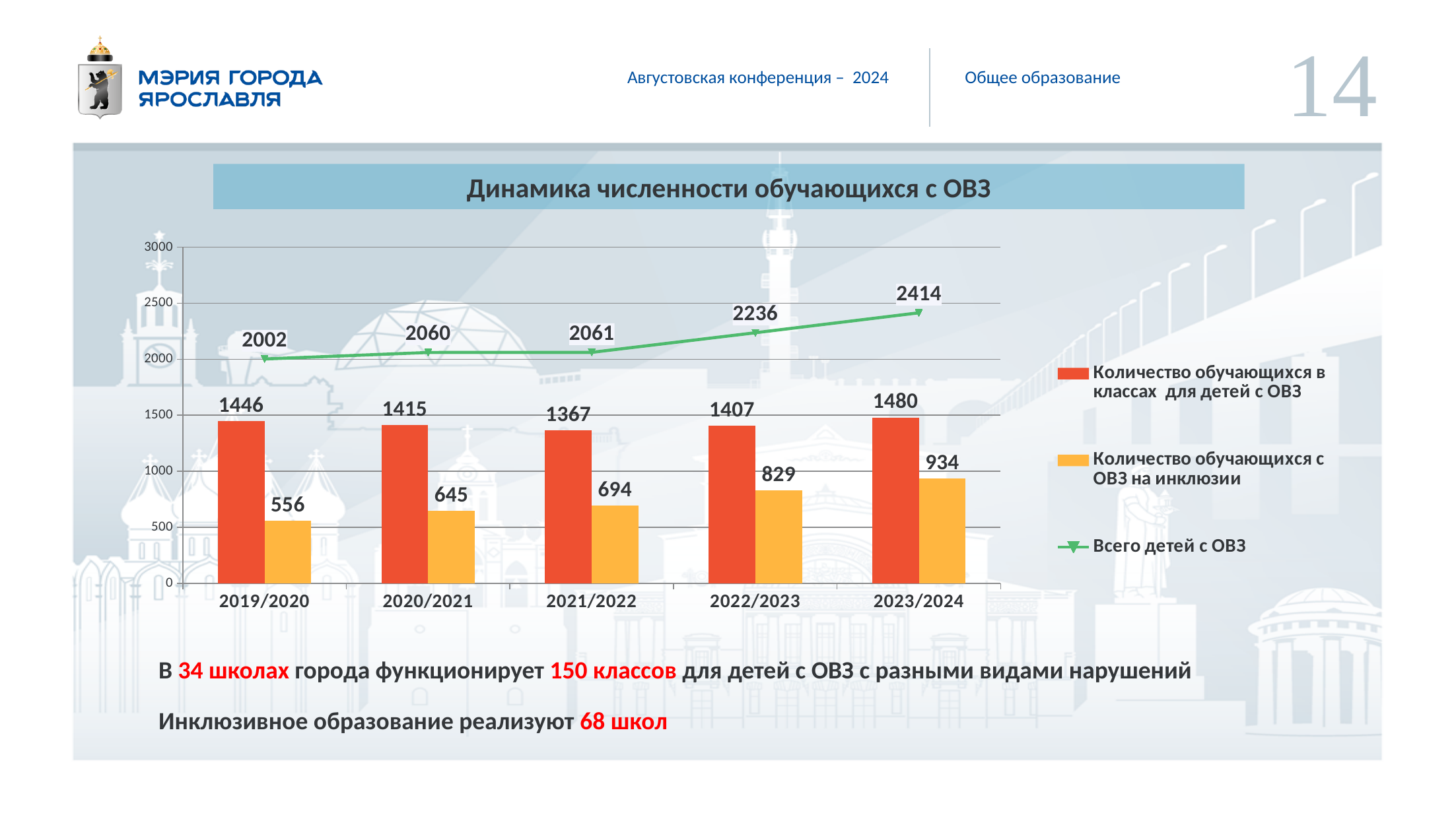
In which year is 'Количество обучающихся в классах для детей с ОВЗ' the lowest? 2021/2022 What is the difference between 'Количество обучающихся с ОВЗ на инклюзии' in 2023/2024 and 2019/2020? 378 What is the value of 'Количество обучающихся в классах для детей с ОВЗ' for 2021/2022? 1367 What is the title of the chart? Динамика численности обучающихся с ОВЗ How many years are shown on the x axis? 5 In which year is 'Всего детей с ОВЗ' the highest? 2023/2024 How many series does the legend list? 3 What is the value of 'Всего детей с ОВЗ' for 2019/2020? 2002 Does 'Количество обучающихся с ОВЗ на инклюзии' rise or fall from 2019/2020 to 2023/2024? rise What is the value of 'Количество обучающихся с ОВЗ на инклюзии' for 2023/2024? 934 Which is larger: 'Количество обучающихся в классах для детей с ОВЗ' in 2019/2020 or in 2020/2021? 2019/2020 What is the difference between 'Всего детей с ОВЗ' in 2023/2024 and 2022/2023? 178